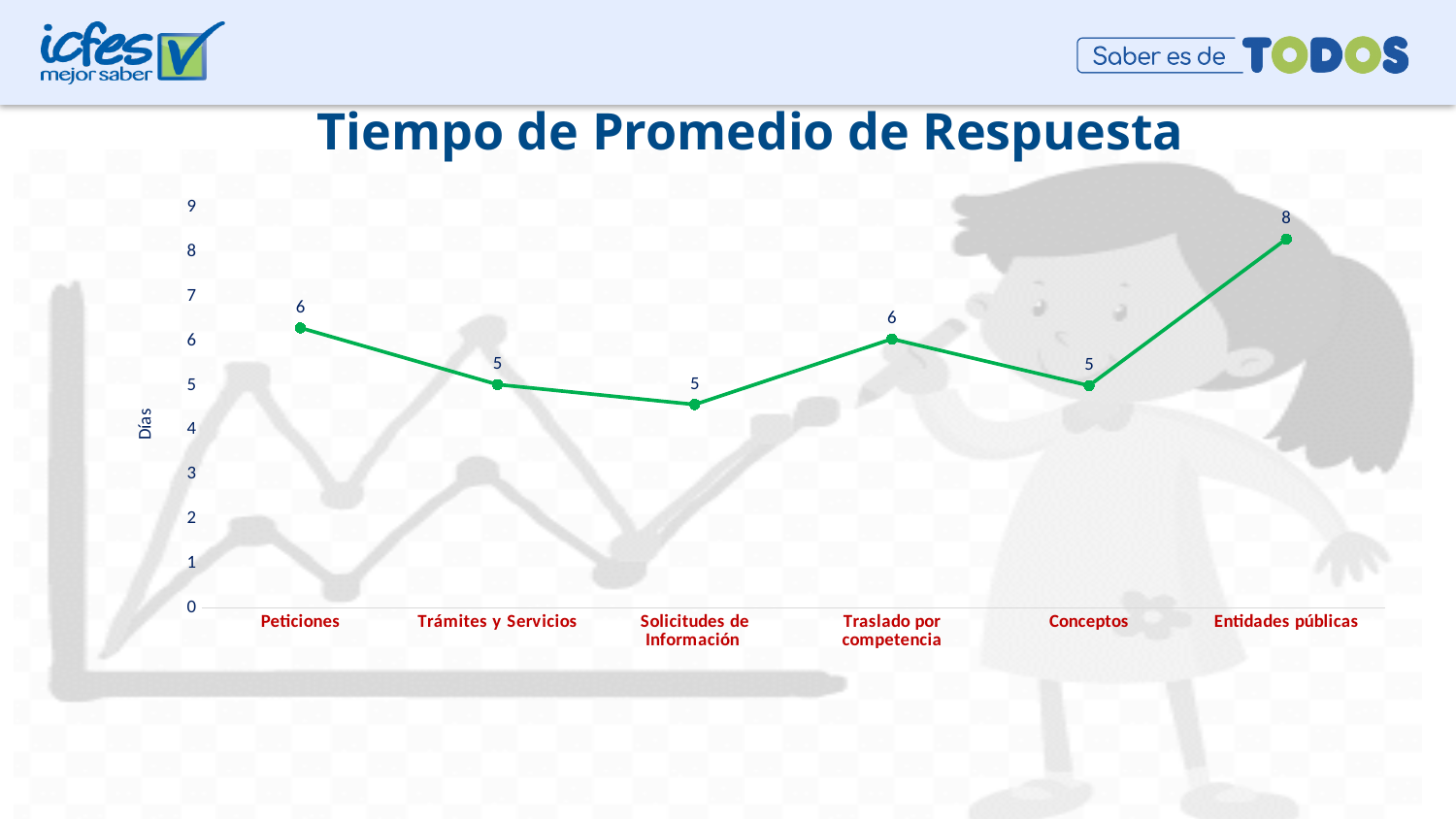
What is the difference between the values for Entidades públicas and Peticiones? 2 Do the values rise or fall from Conceptos to Entidades públicas? rise Which is larger, the value for Entidades públicas or the value for Trámites y Servicios? Entidades públicas Which category has the highest value? Entidades públicas What is the value for Conceptos? 5 What is the value for Entidades públicas? 8 What is the value for Traslado por competencia? 6 What is the value for Peticiones? 6 Is the value for Entidades públicas greater or less than 7? greater What kind of chart is shown on the slide? line chart How many categories are shown on the x axis? 6 What is the label on the y axis? Días